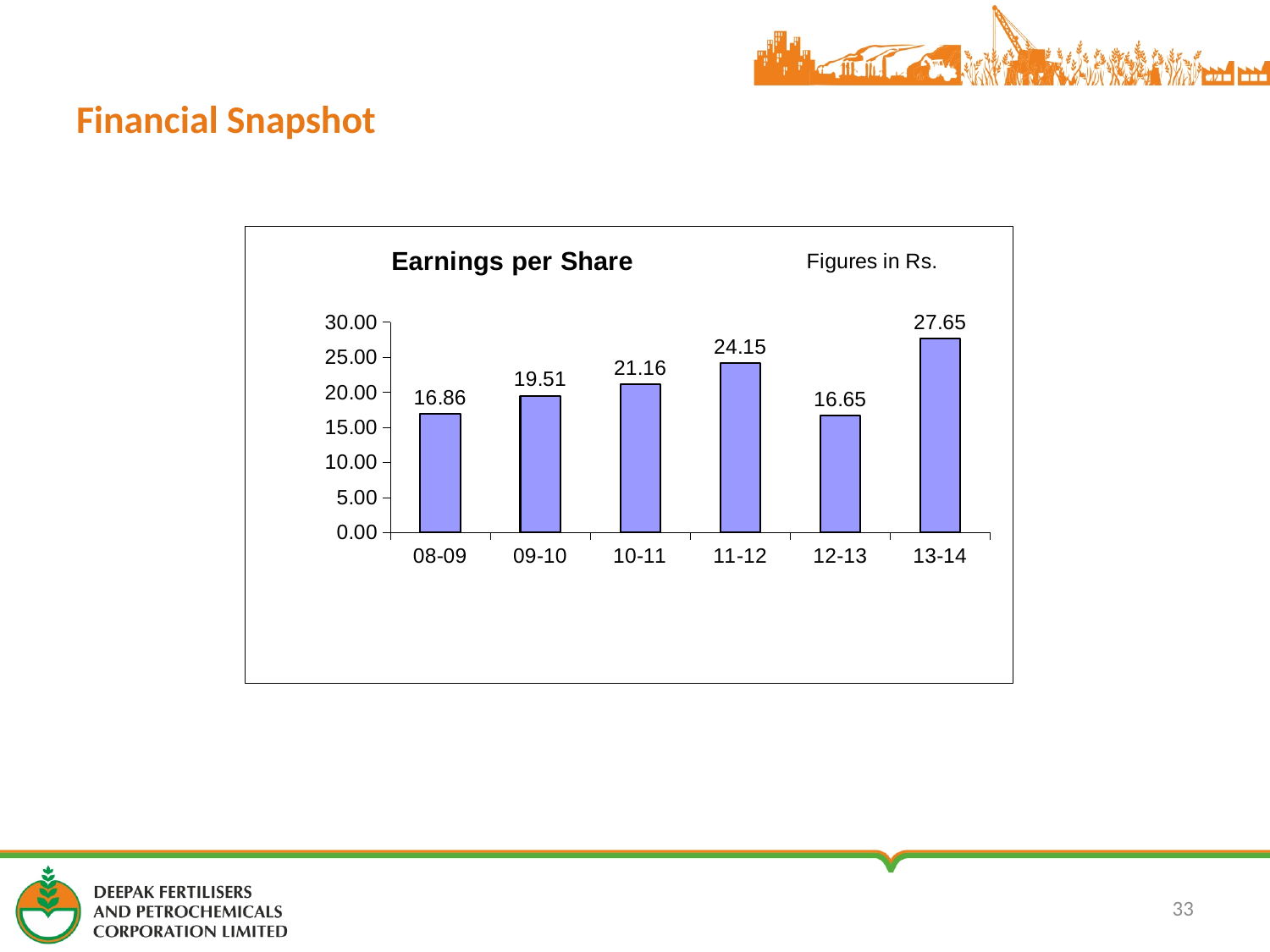
What is the difference in earnings per share between 13-14 and 12-13? 11.00 Which year has the highest earnings per share? 13-14 What is the difference in earnings per share between 11-12 and 10-11? 2.99 What type of chart is used to show earnings per share? bar chart What is the earnings per share for 11-12? 24.15 What is the earnings per share for 08-09? 16.86 In what unit are the figures on the chart given? Rs. Is the earnings per share for 11-12 greater or less than 20.00? greater Which year has a higher earnings per share, 09-10 or 12-13? 09-10 Which year has the lowest earnings per share? 12-13 How many years are shown on the chart? 6 What is the earnings per share for 13-14? 27.65